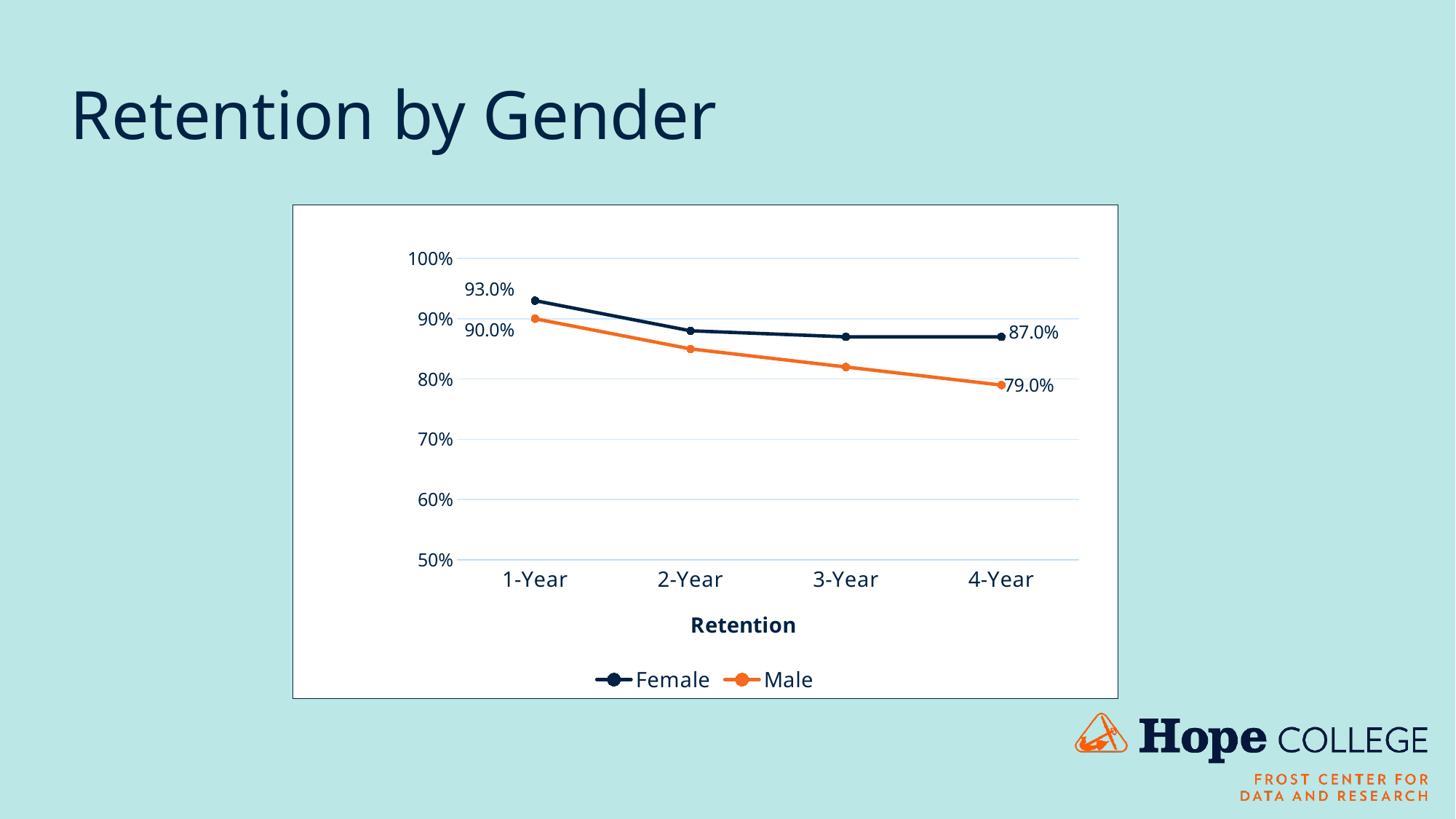
What is the Male retention value at 1-Year? 90.0% How many series does the legend list? 2 By how much does the Male retention value fall from 1-Year to 4-Year? 11.0 percentage points What is the difference between the Female and Male retention values at 4-Year? 8.0 percentage points Which series has the higher retention value at 4-Year, Female or Male? Female What is the Female retention value at 1-Year? 93.0% How many time points are plotted on the x axis? 4 Do the Male retention values rise or fall from 1-Year to 4-Year? Fall What kind of chart is shown on the slide? Line chart Is the Male retention value at 2-Year greater or less than 90%? less What is the Female retention value at 4-Year? 87.0% What is the Male retention value at 4-Year? 79.0%